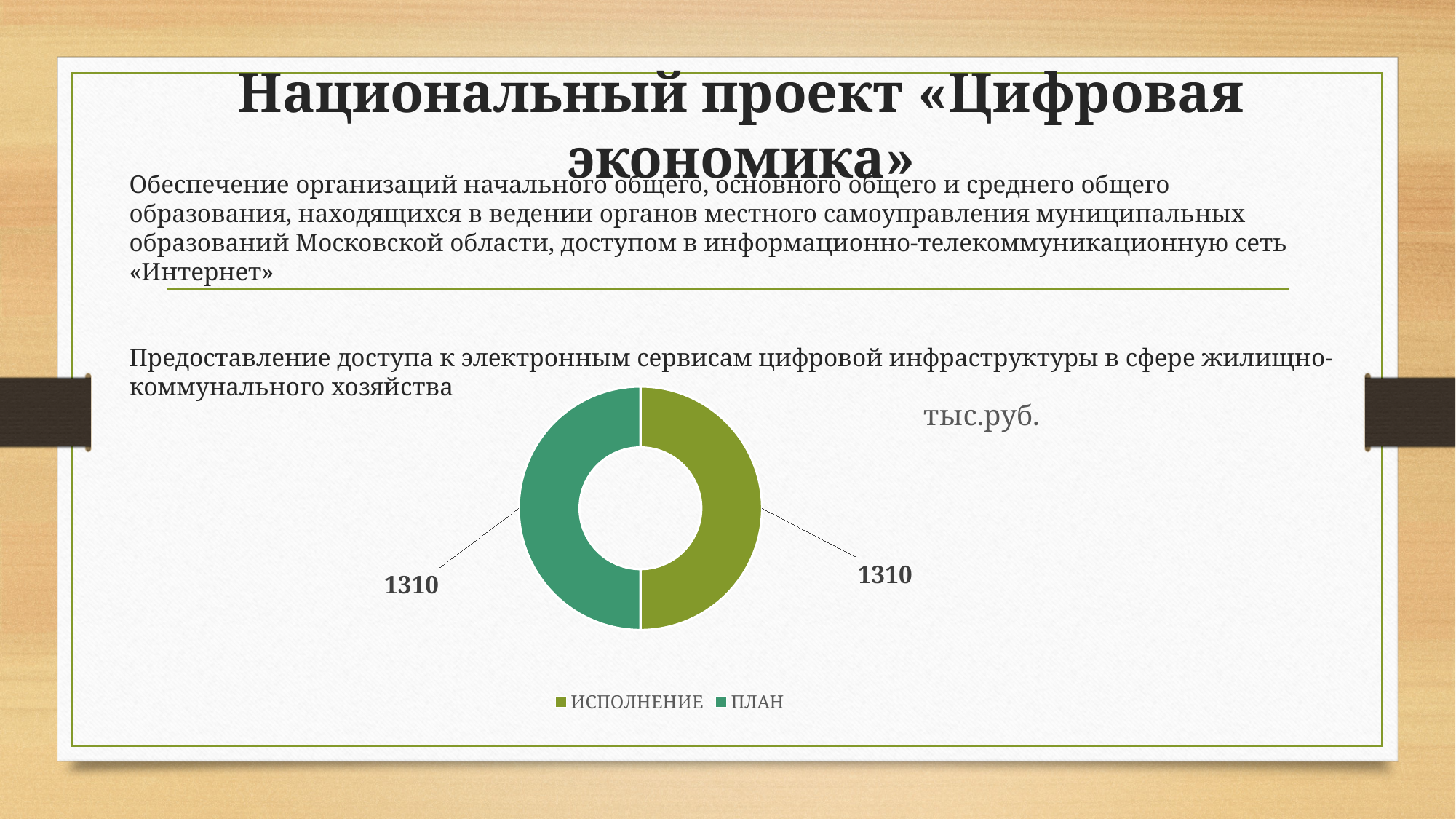
What is the value for ИСПОЛНЕНИЕ in the chart? 1310 What unit is indicated next to the chart? тыс.руб. Which legend entry is shown in the lighter olive-green colour? ИСПОЛНЕНИЕ What is the value for ПЛАН in the chart? 1310 What share of the chart does the ИСПОЛНЕНИЕ slice represent? 50% What is the total of the two slices in the chart? 2620 How many entries does the chart legend list? 2 What is the difference between the value for ПЛАН and the value for ИСПОЛНЕНИЕ? 0 What kind of chart is shown on the slide? Doughnut (pie) chart Which is larger, the value for ИСПОЛНЕНИЕ or the value for ПЛАН? They are equal How many slices does the chart have? 2